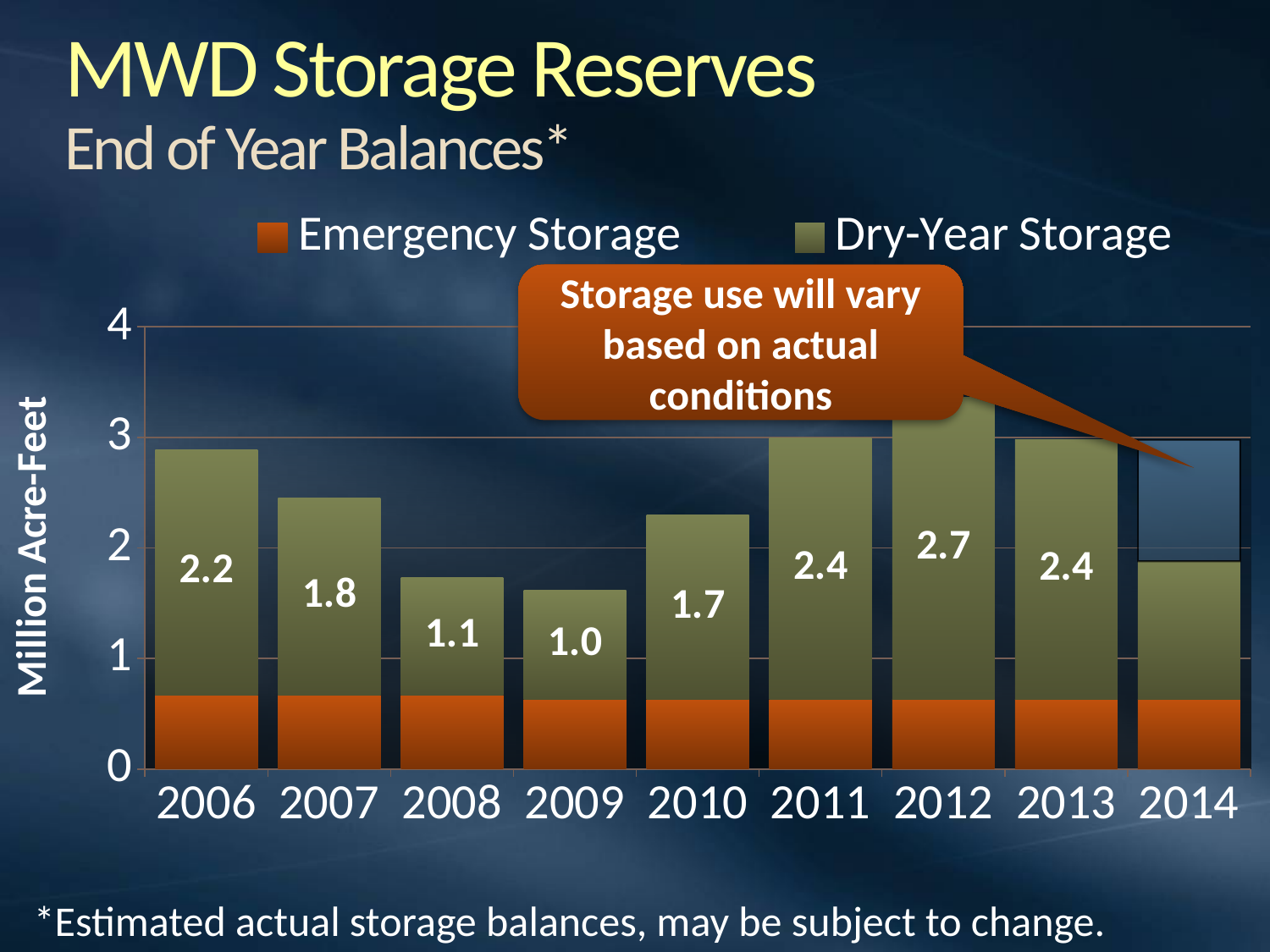
What is the difference between the Dry-Year Storage values for 2012 and 2009? 1.7 How many years are shown on the x axis? 9 How many series does the legend list? 2 What is the Dry-Year Storage value for 2010? 1.7 Which year has the lowest labelled Dry-Year Storage value? 2009 Is the total stacked bar height for 2012 greater or less than 3? greater Which year has the highest labelled Dry-Year Storage value? 2012 Do the Dry-Year Storage values rise or fall from 2006 to 2009? Fall What is the Dry-Year Storage value for 2012? 2.7 What is the Dry-Year Storage value for 2006? 2.2 What kind of chart is shown on the slide? Stacked bar chart Which year has a larger Dry-Year Storage value, 2007 or 2008? 2007